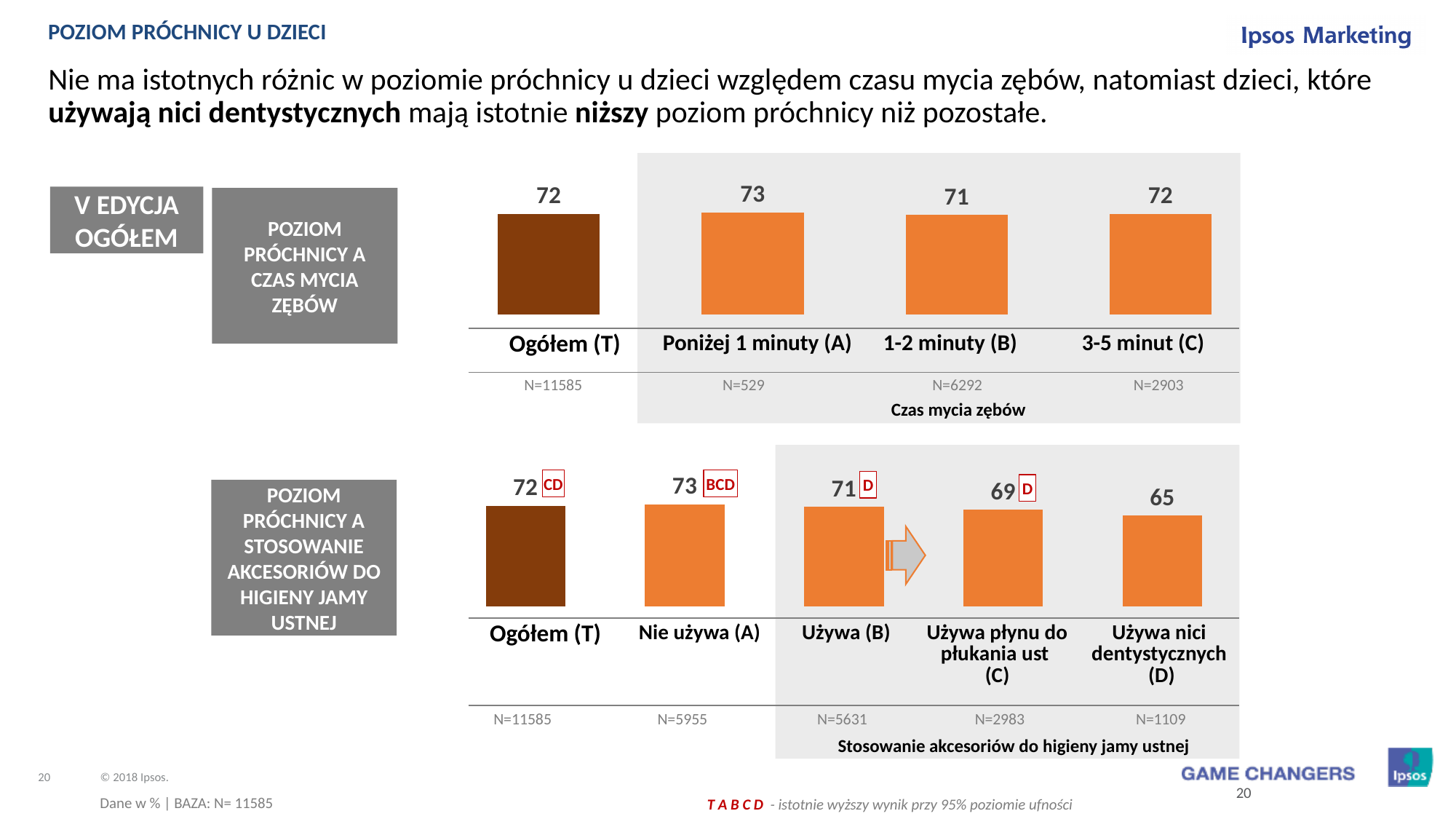
In the top chart (Poziom próchnicy a czas mycia zębów), what is the value for 'Poniżej 1 minuty (A)'? 73 What type of chart is the top chart (Poziom próchnicy a czas mycia zębów)? Bar chart In the bottom chart (Poziom próchnicy a stosowanie akcesoriów do higieny jamy ustnej), which is larger: 'Używa (B)' or 'Używa płynu do płukania ust (C)'? Używa (B) In the bottom chart (Poziom próchnicy a stosowanie akcesoriów do higieny jamy ustnej), what is the value for 'Używa płynu do płukania ust (C)'? 69 In the top chart (Poziom próchnicy a czas mycia zębów), which category has the lowest value? 1-2 minuty (B) In the bottom chart (Poziom próchnicy a stosowanie akcesoriów do higieny jamy ustnej), which category has the highest value? Nie używa (A) In the top chart (Poziom próchnicy a czas mycia zębów), how many bars are plotted? 4 In the bottom chart (Poziom próchnicy a stosowanie akcesoriów do higieny jamy ustnej), how many categories are plotted? 5 In the bottom chart (Poziom próchnicy a stosowanie akcesoriów do higieny jamy ustnej), what is the difference between 'Nie używa (A)' and 'Używa nici dentystycznych (D)'? 8 In the bottom chart (Poziom próchnicy a stosowanie akcesoriów do higieny jamy ustnej), which category has the lowest value? Używa nici dentystycznych (D) In the bottom chart (Poziom próchnicy a stosowanie akcesoriów do higieny jamy ustnej), what is the value for 'Używa nici dentystycznych (D)'? 65 In the top chart (Poziom próchnicy a czas mycia zębów), what is the value for '1-2 minuty (B)'? 71